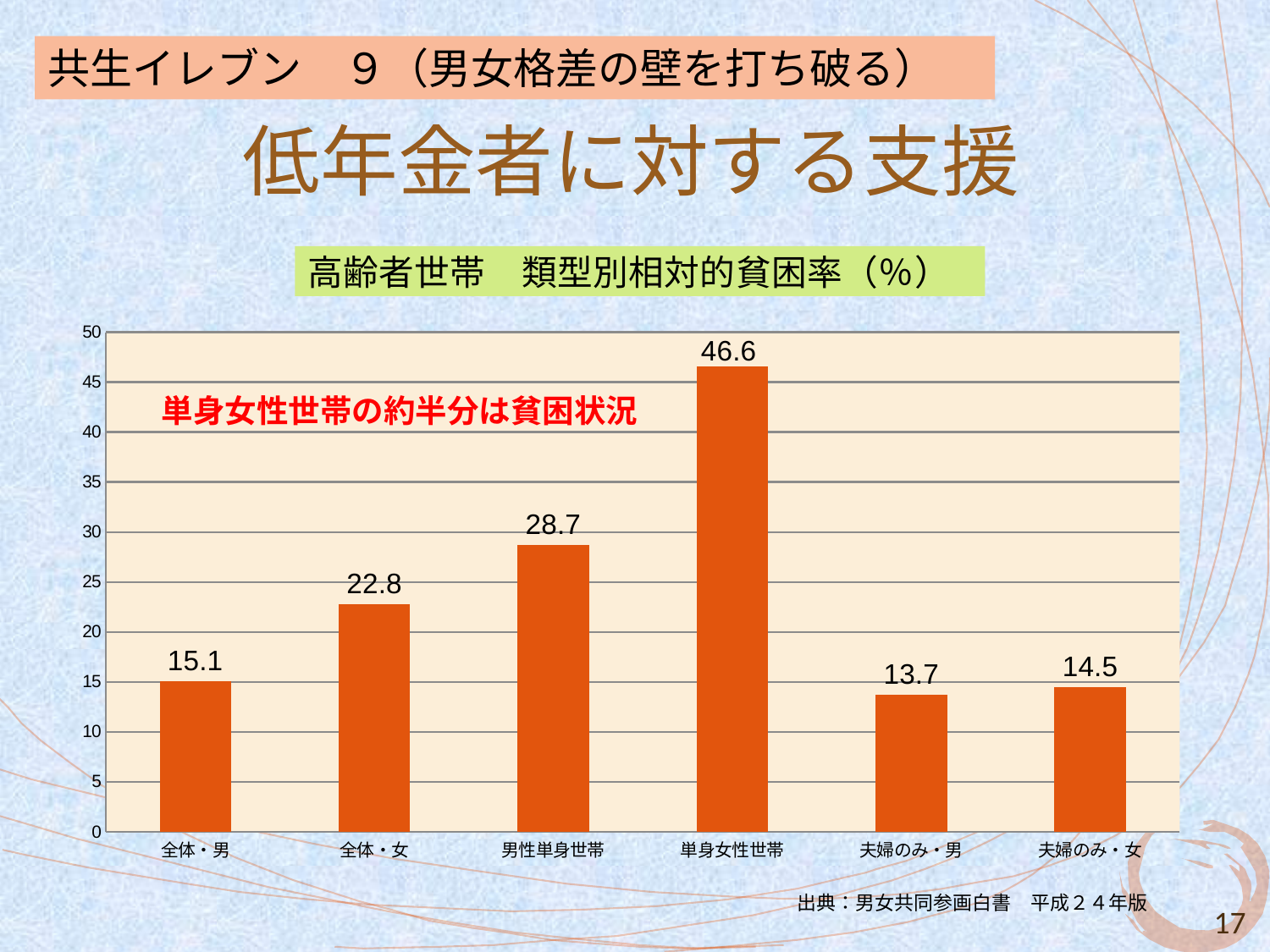
Which category has the highest value? 単身女性世帯 What is the value for 全体・男? 15.1 How many categories are shown on the x axis? 6 What is the value for 単身女性世帯? 46.6 What is the difference between the values for 全体・女 and 全体・男? 7.7 What kind of chart is shown on the slide? bar chart Is the value for 男性単身世帯 greater or less than 25? greater What is the difference between the values for 単身女性世帯 and 男性単身世帯? 17.9 What is the value for 夫婦のみ・女? 14.5 Which is larger, the value for 全体・女 or the value for 夫婦のみ・女? 全体・女 Which category has the lowest value? 夫婦のみ・男